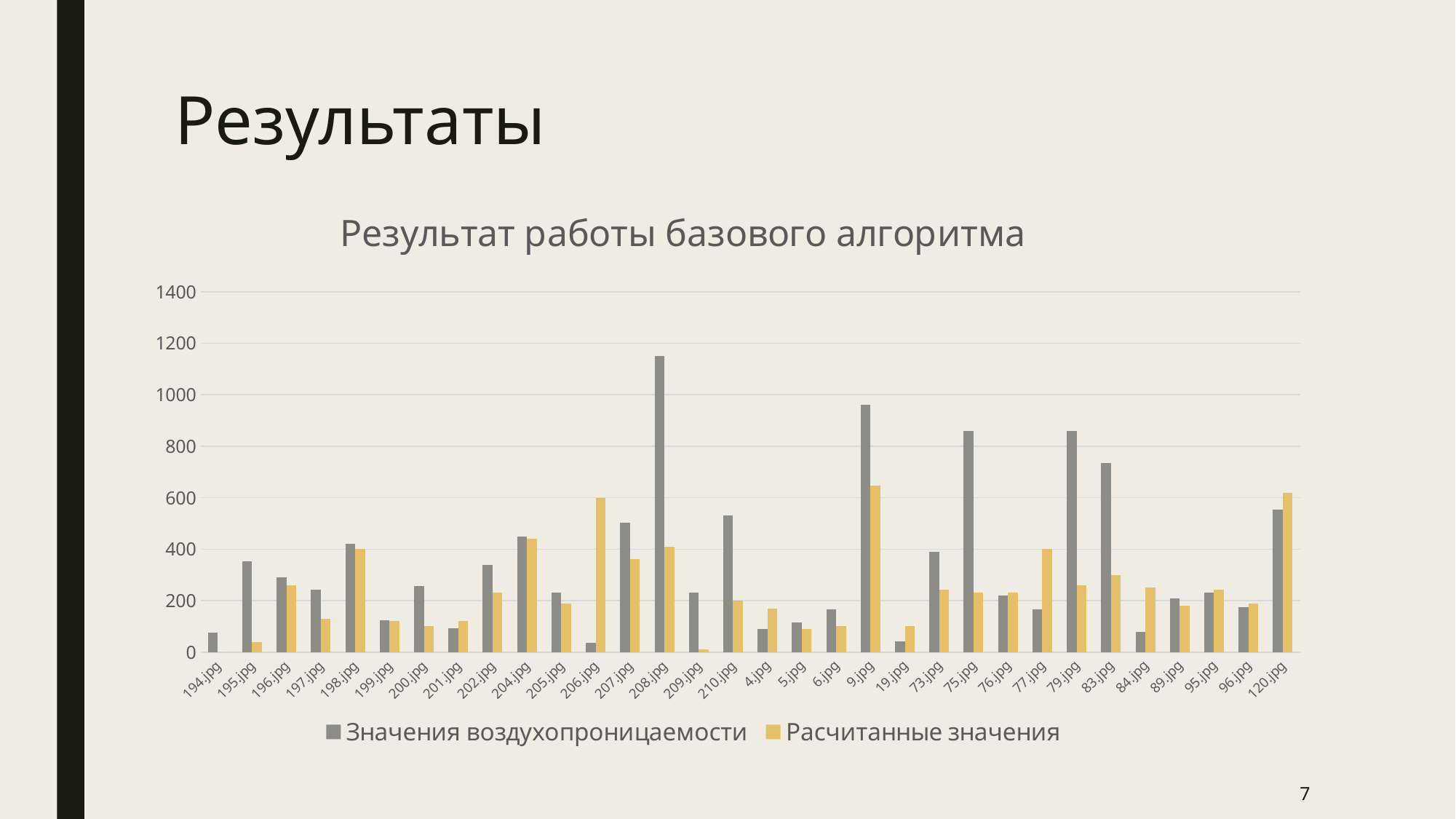
What kind of chart is shown on the slide? bar chart What is the title of the chart? Результат работы базового алгоритма How many series does the legend list? 2 Is the value of Значения воздухопроницаемости for 194.jpg greater or less than 200? less Which category has the highest value for Значения воздухопроницаемости? 208.jpg For 208.jpg, which series has the larger value: Значения воздухопроницаемости or Расчитанные значения? Значения воздухопроницаемости Is the value of Значения воздухопроницаемости for 208.jpg greater or less than 1000? greater Which category has the lowest value for Расчитанные значения? 194.jpg For 206.jpg, which series has the larger value: Значения воздухопроницаемости or Расчитанные значения? Расчитанные значения Is the value of Расчитанные значения for 206.jpg greater or less than 400? greater How many categories are shown on the x axis? 32